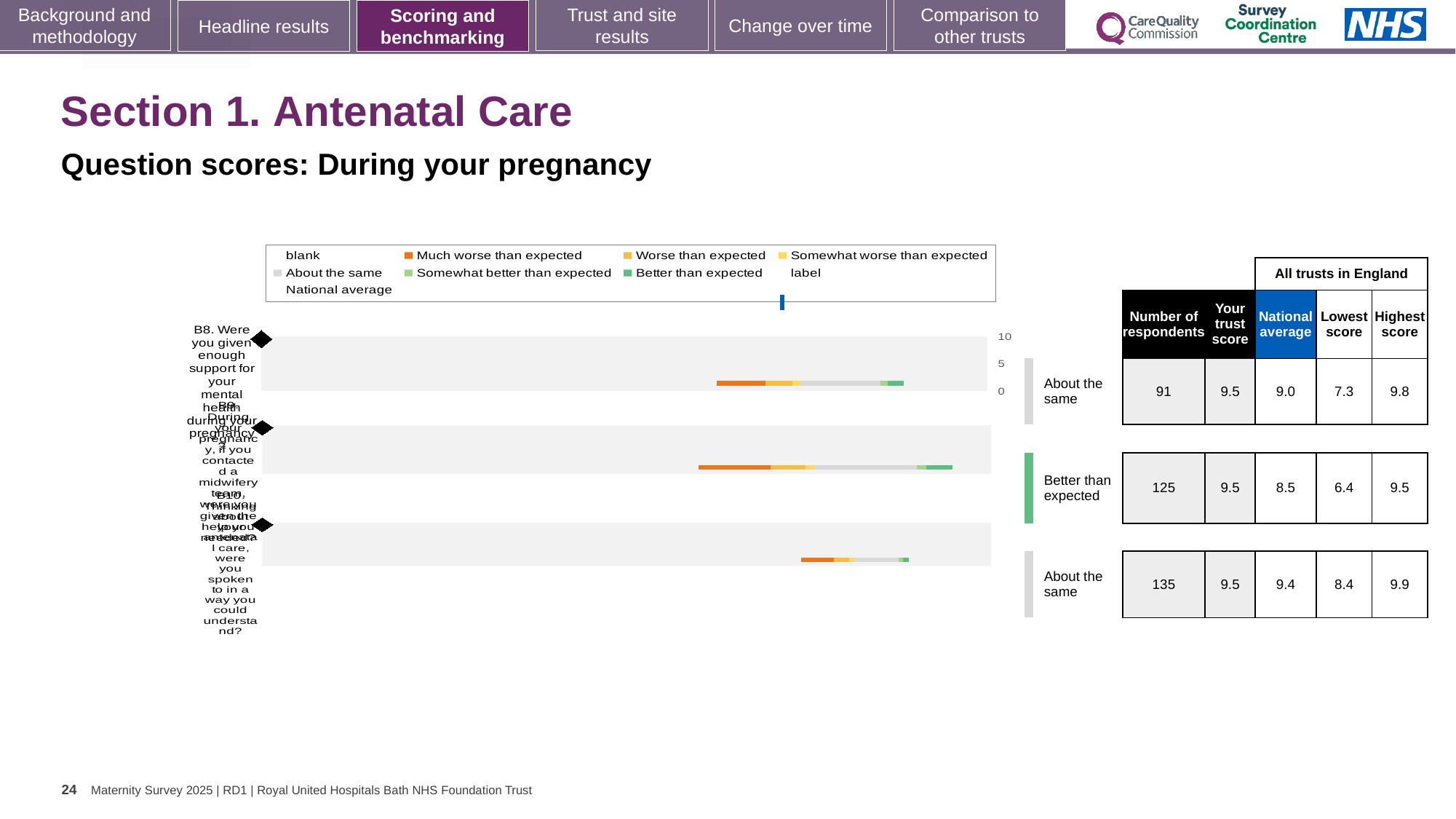
Which row has the lowest 'Lowest score' value in the table? the second row (6.4) In the table, what is the trust score for the third row? 9.5 Which row has the highest number of respondents? the third row (135) What is the difference in number of respondents between the third row and the first row? 44 What kind of chart is shown on the slide? bar chart In the table, what is the national average for the second row? 8.5 For the first row, which is larger: the trust score or the national average? the trust score (9.5) What is the heading above the National average, Lowest score and Highest score columns? All trusts in England How many question rows (bars) are plotted in the chart? 3 In the table next to the chart, what is the number of respondents for the first row (B8)? 91 In the table, what is the highest score for the third row? 9.9 What benchmark category is shown for the second row? Better than expected